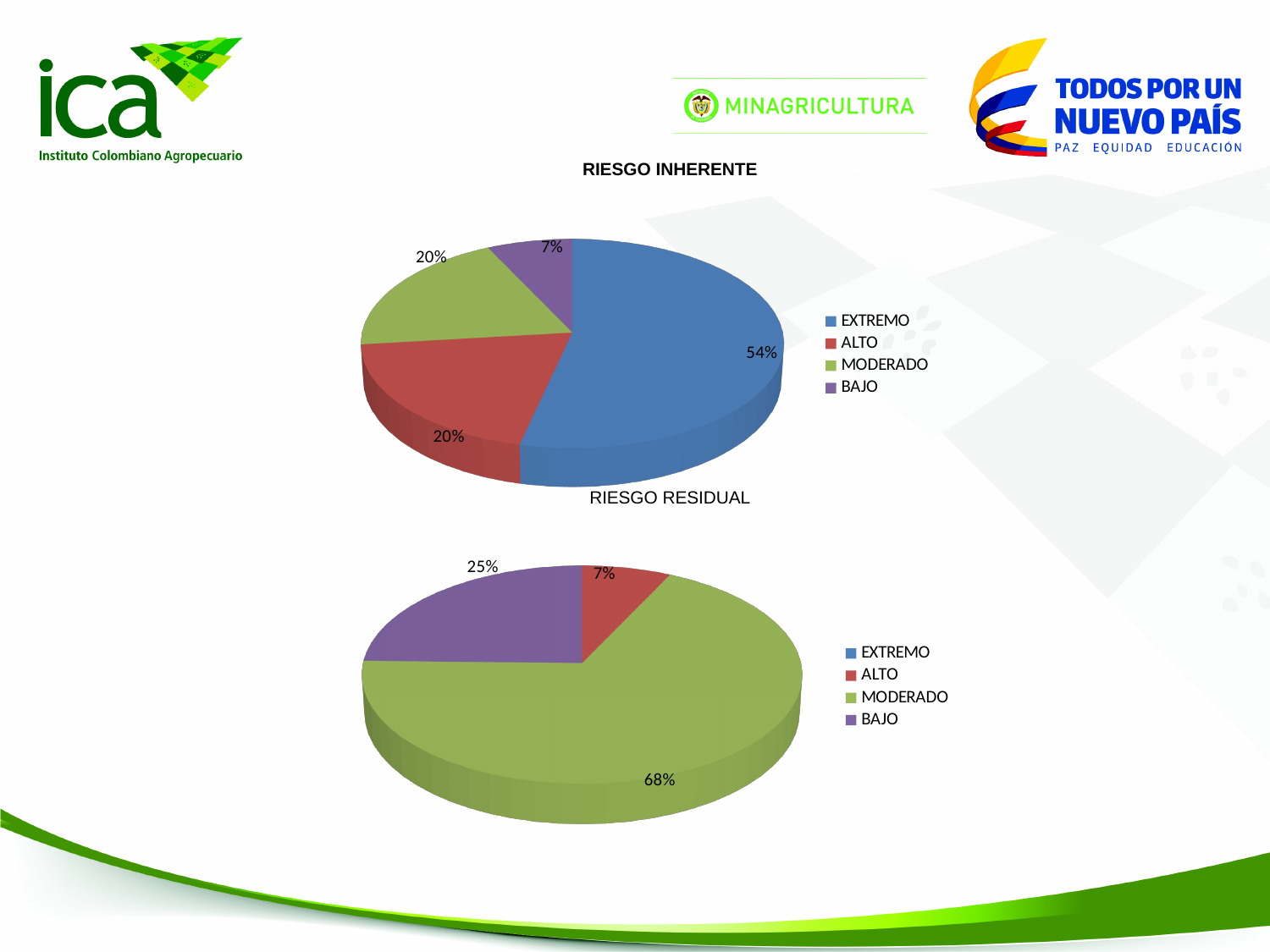
In the RIESGO RESIDUAL chart, which category has the largest slice? MODERADO In the RIESGO RESIDUAL chart, which is larger, BAJO or ALTO? BAJO In the RIESGO RESIDUAL chart, what is the difference between the MODERADO and BAJO shares? 43% In the RIESGO RESIDUAL chart, what share does MODERADO have? 68% What type of chart is the RIESGO INHERENTE chart? Pie chart In the RIESGO INHERENTE chart, what is the difference between the EXTREMO and ALTO shares? 34% In the RIESGO INHERENTE chart, what share does BAJO have? 7% In the RIESGO INHERENTE chart, which category has the smallest slice? BAJO How many entries does the legend of the RIESGO RESIDUAL chart list? 4 In the RIESGO INHERENTE chart, what share does EXTREMO have? 54% In the RIESGO RESIDUAL chart, what share does BAJO have? 25% In the RIESGO INHERENTE chart, which category has the largest slice? EXTREMO